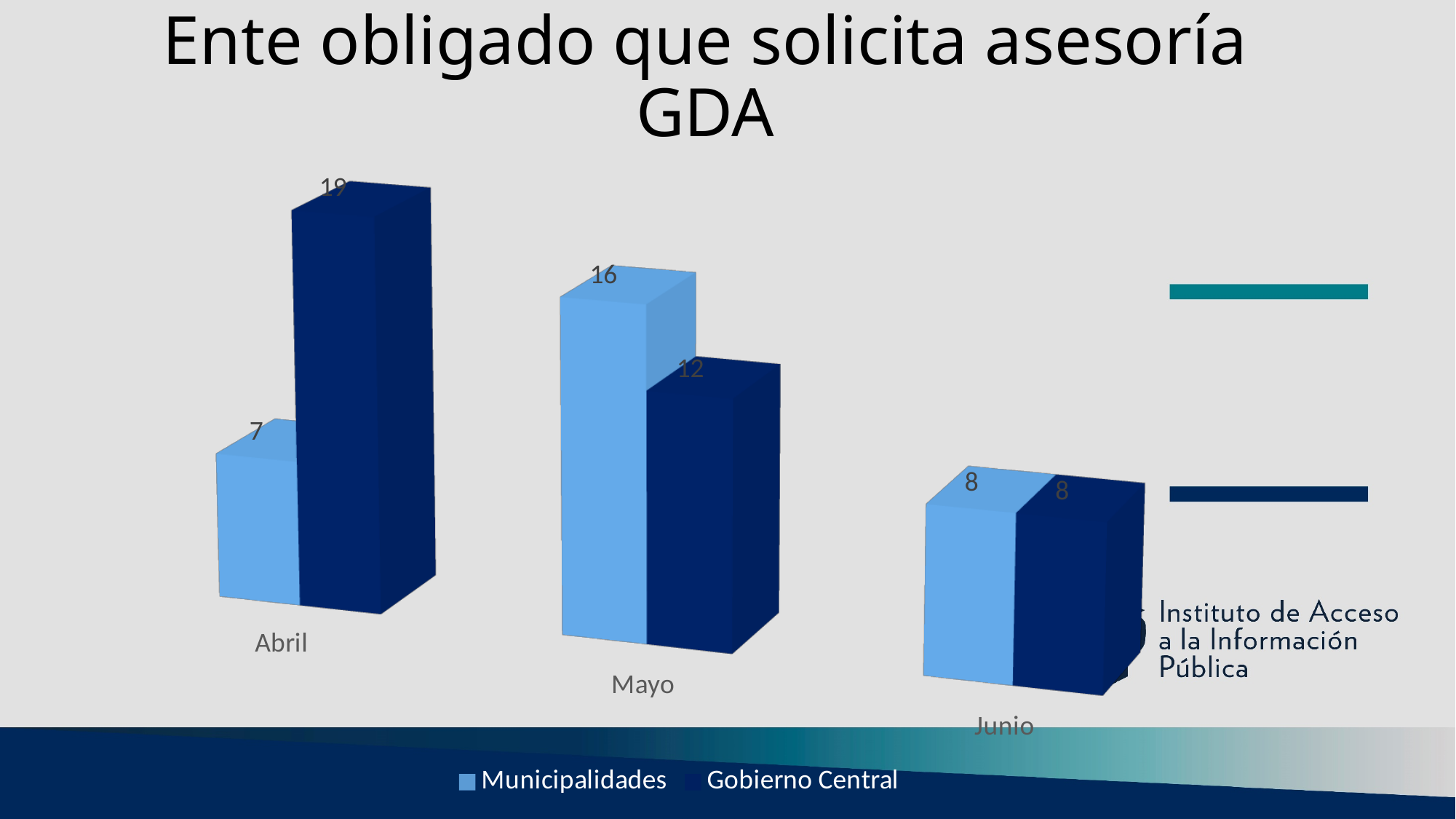
What is the difference between Gobierno Central and Municipalidades in Abril? 12 In Mayo, which series has the larger value, Municipalidades or Gobierno Central? Municipalidades What is the value for Gobierno Central in Abril? 19 What kind of chart is shown on the slide? Bar chart What is the value for Municipalidades in Abril? 7 How many months are shown on the x axis? 3 What is the value for Municipalidades in Mayo? 16 What is the value for Gobierno Central in Mayo? 12 In which month is the Municipalidades value lowest? Abril What is the value for Municipalidades in Junio? 8 How many series does the legend list? 2 In which month is the Gobierno Central value highest? Abril